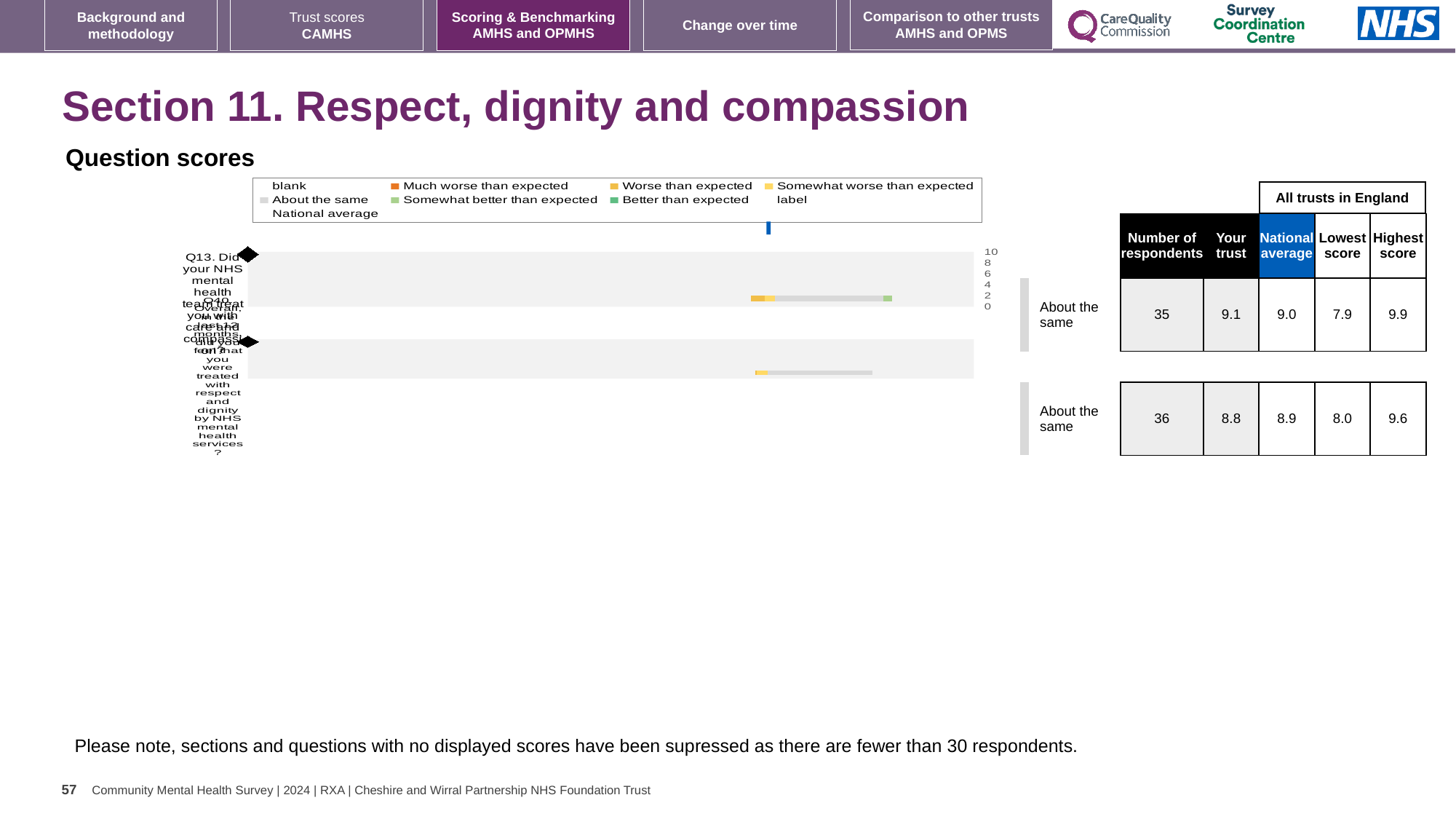
What kind of chart is shown under 'Question scores'? bar chart In the table beside the chart, what is the 'Your trust' score for the second row (Q10)? 8.8 In the table beside the chart, what is the number of respondents for the second row (Q10)? 36 In the table beside the chart, what is the highest score for the first row (Q13)? 9.9 In the table beside the chart, what is the 'Your trust' score for the first row (Q13)? 9.1 In the table beside the chart, what is the national average for the first row (Q13)? 9.0 In the table beside the chart, which row has the higher 'Your trust' score, the first row (Q13) or the second row (Q10)? Q13 In the table beside the chart, what is the lowest score for the second row (Q10)? 8.0 How many entries does the chart legend list? 9 How many question rows (categories) does the bar chart show? 2 In the table beside the chart, what is the difference between the highest score and the lowest score for the first row (Q13)? 2.0 What rating label is shown next to both rows of the chart? About the same